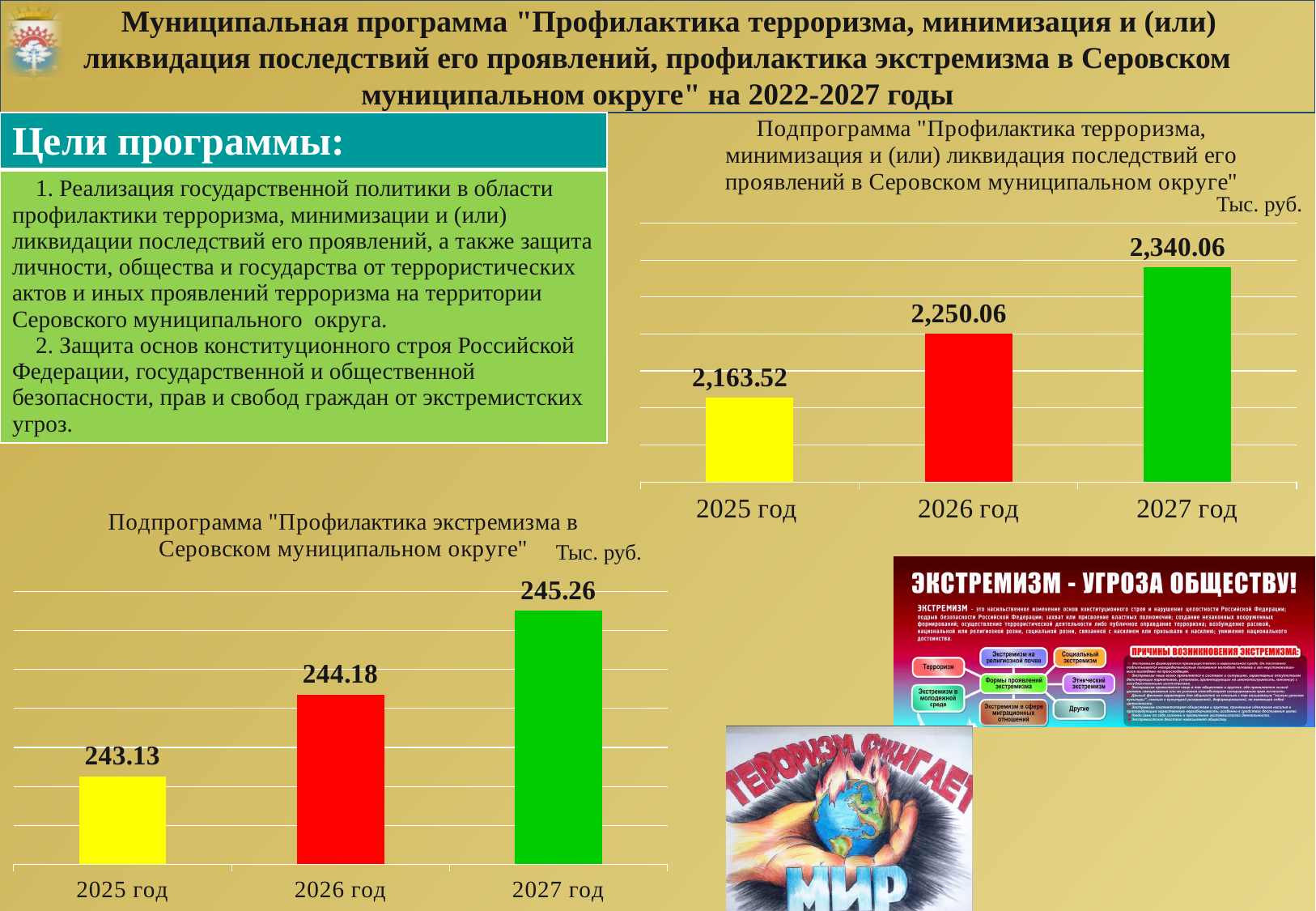
In the bottom-left chart (Подпрограмма "Профилактика экстремизма..."), what is the value for 2027 год? 245.26 In the bottom-left chart (Подпрограмма "Профилактика экстремизма..."), which year has the lowest value? 2025 год In the top-right chart (Подпрограмма "Профилактика терроризма..."), what is the value for 2027 год? 2,340.06 In the bottom-left chart (Подпрограмма "Профилактика экстремизма..."), what is the value for 2026 год? 244.18 In the top-right chart (Подпрограмма "Профилактика терроризма..."), do the values rise or fall from 2025 год to 2027 год? rise In the top-right chart (Подпрограмма "Профилактика терроризма..."), which year has the highest value? 2027 год In the bottom-left chart (Подпрограмма "Профилактика экстремизма..."), how many years are shown? 3 What unit is indicated for the values in the bottom-left chart (Подпрограмма "Профилактика экстремизма...")? Тыс. руб. In the top-right chart (Подпрограмма "Профилактика терроризма..."), what is the difference between the values for 2027 год and 2025 год? 176.54 What type of chart is the top-right chart (Подпрограмма "Профилактика терроризма...")? bar chart In the bottom-left chart (Подпрограмма "Профилактика экстремизма..."), what is the difference between the values for 2027 год and 2025 год? 2.13 In the top-right chart (Подпрограмма "Профилактика терроризма..."), what is the value for 2025 год? 2,163.52